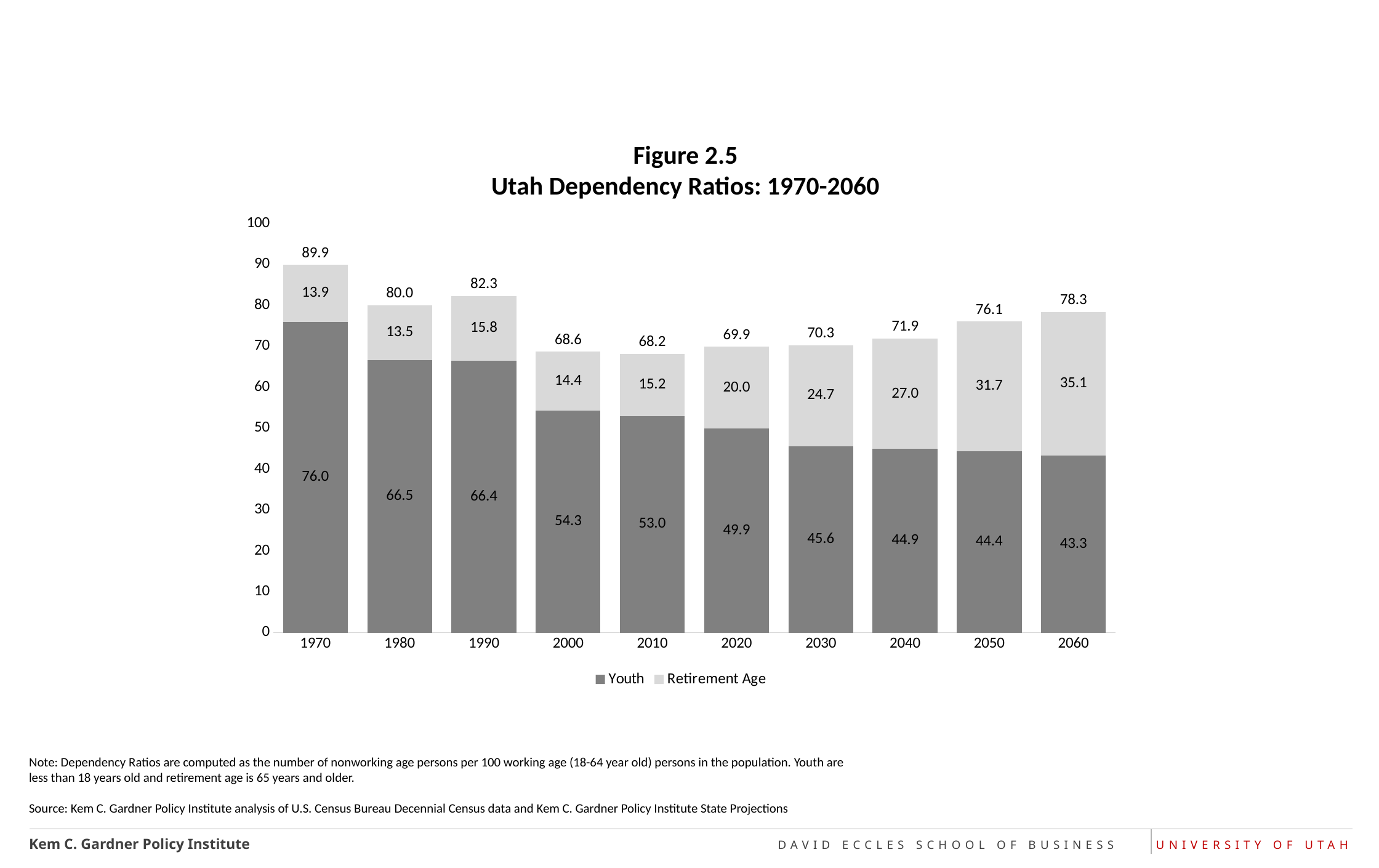
What is the title of the chart? Figure 2.5 Utah Dependency Ratios: 1970-2060 Which is larger, the Youth value for 2020 or the Youth value for 2030? 2020 What is the Youth dependency ratio for 1970? 76.0 Which year has the lowest Youth dependency ratio? 2060 What kind of chart is shown? Stacked bar chart What is the Retirement Age dependency ratio for 2060? 35.1 How many years are shown on the x axis? 10 Which year has the highest total dependency ratio? 1970 Does the Retirement Age value rise or fall from 2000 to 2060? Rise How many series does the legend list? 2 What is the total dependency ratio shown above the bar for 2000? 68.6 What is the difference between the Retirement Age values for 2060 and 1970? 21.2